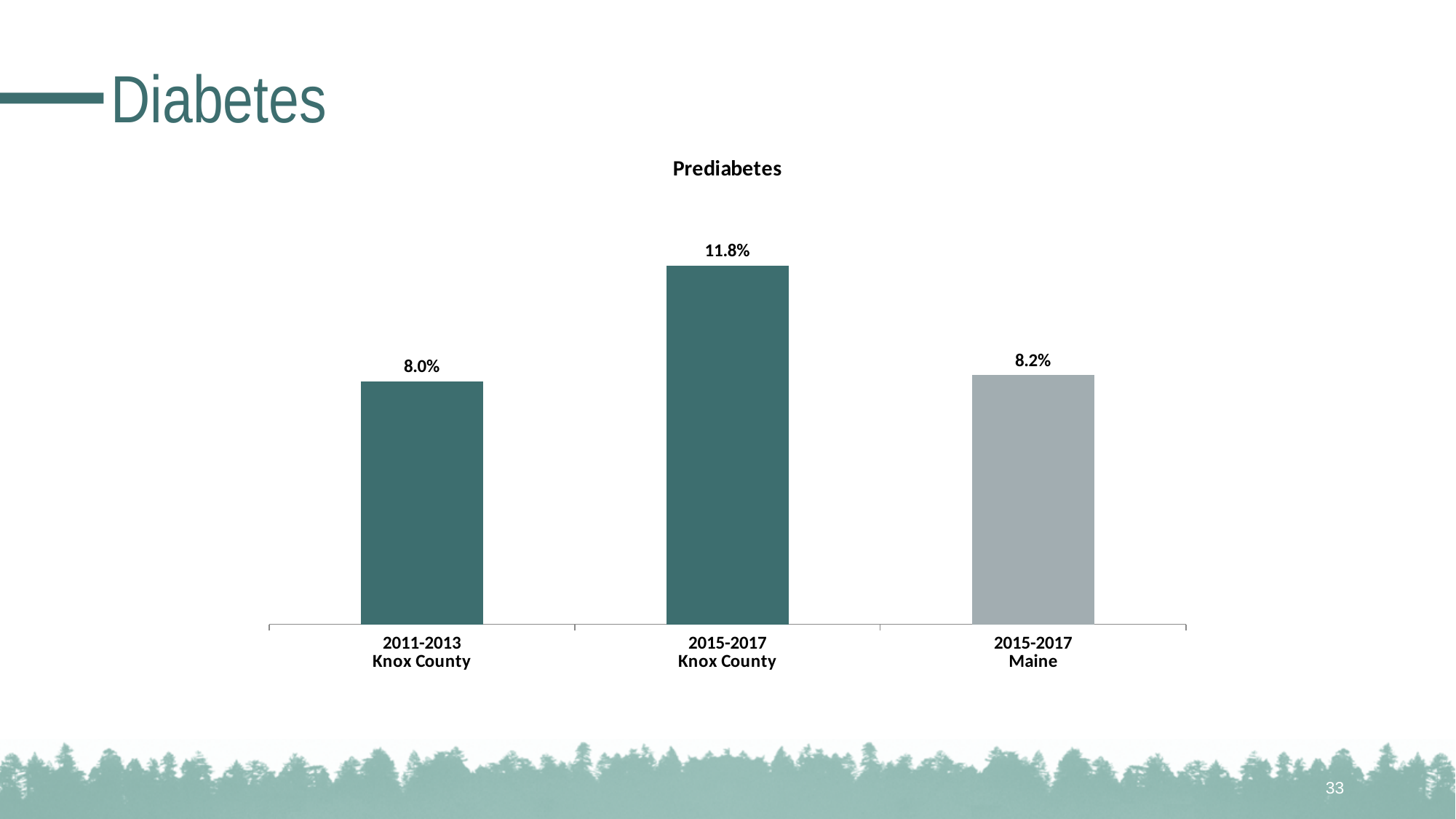
What is the prediabetes value for 2011-2013 Knox County? 8.0% How many bars are shown in the chart? 3 Which bar is shown in grey rather than dark teal? 2015-2017 Maine Which category has the highest prediabetes value? 2015-2017 Knox County What is the difference between the 2015-2017 Maine value and the 2011-2013 Knox County value? 0.2% What is the difference between the 2015-2017 Knox County value and the 2011-2013 Knox County value? 3.8% What is the prediabetes value for 2015-2017 Knox County? 11.8% What is the title of the chart? Prediabetes Which category has the lowest prediabetes value? 2011-2013 Knox County Which is larger, the 2015-2017 Knox County value or the 2015-2017 Maine value? 2015-2017 Knox County What kind of chart is shown on the slide? Bar chart What is the prediabetes value for 2015-2017 Maine? 8.2%